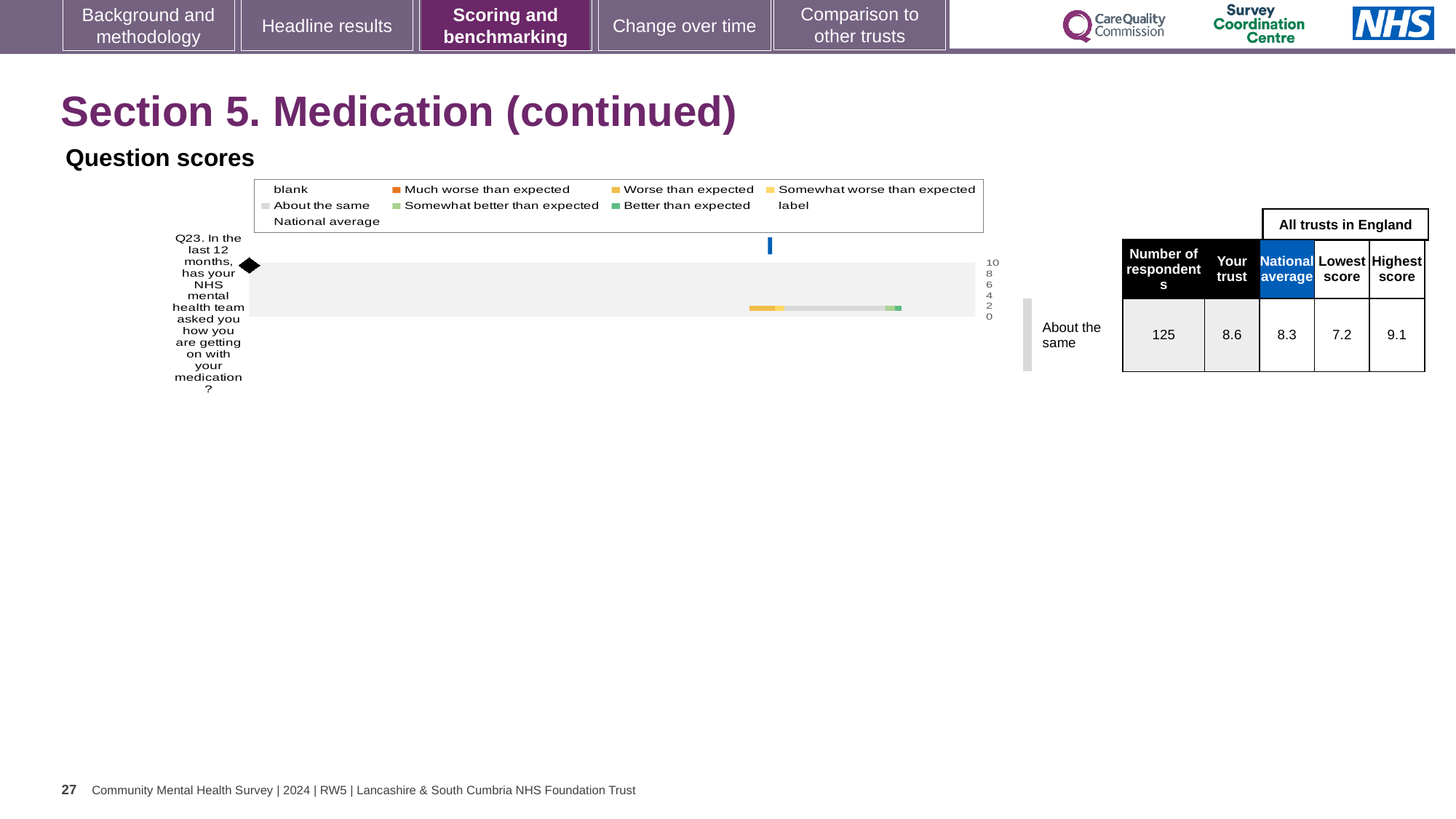
What is the difference between the highest and lowest scores for Q23 across all trusts in England? 1.9 Is the trust's score for Q23 higher or lower than the national average? higher In the table beside the chart, how many respondents answered Q23? 125 In the table beside the chart, what is the highest score among all trusts in England for Q23? 9.1 According to the label beside the chart, how is the trust's result for Q23 categorised? About the same In the table beside the chart, what is the lowest score among all trusts in England for Q23? 7.2 In the table beside the chart, what is the 'Your trust' score for Q23? 8.6 In the table beside the chart, what is the national average score for Q23? 8.3 Which question number is plotted in the Question scores chart? Q23 What is the highest value shown on the axis of the Question scores chart? 10 How many questions (categories) are plotted in the Question scores chart? 1 What kind of chart is shown under 'Question scores'? bar chart